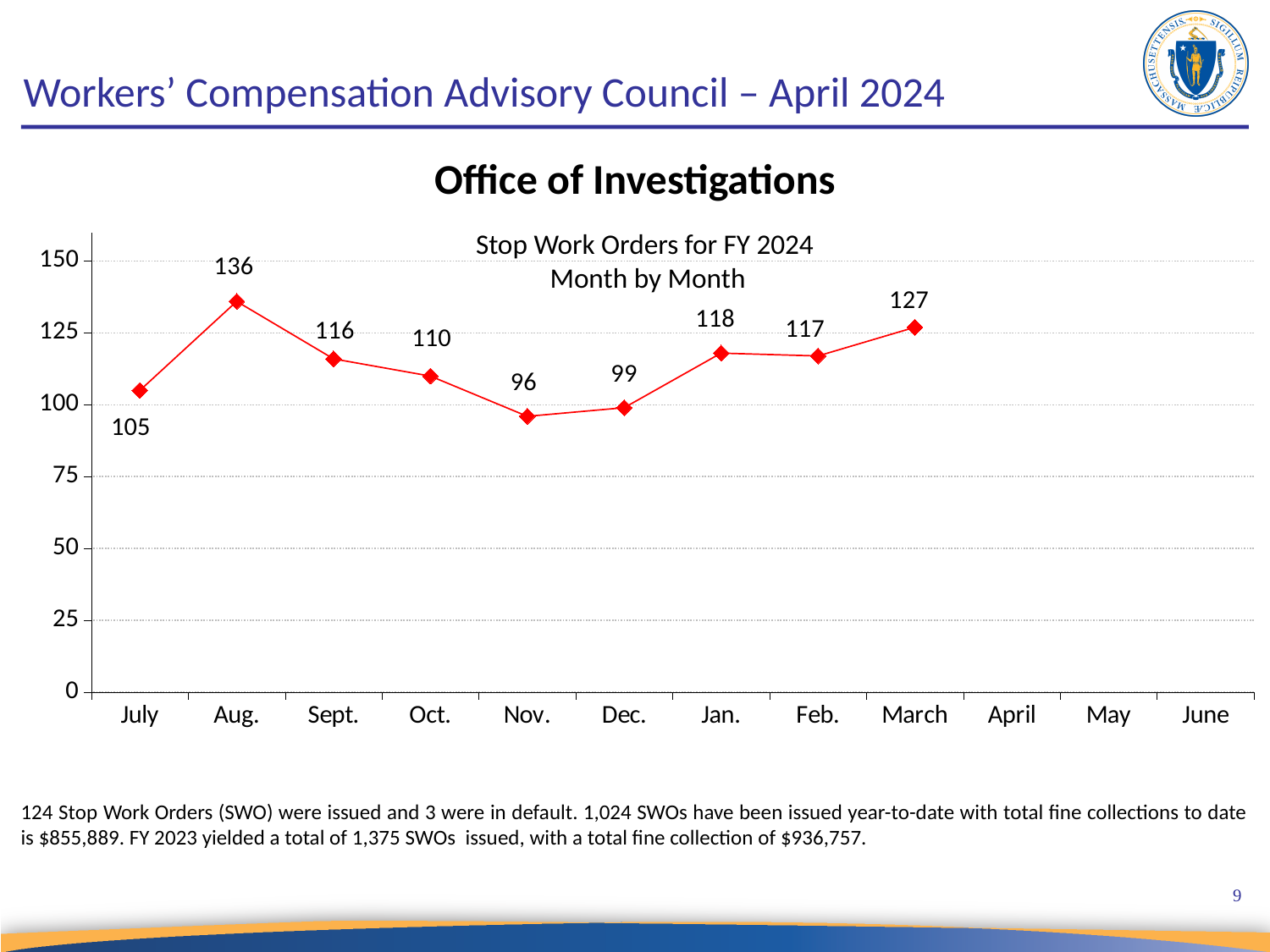
What is the value for Aug. in the Stop Work Orders for FY 2024 chart? 136 What is the difference between the values for Aug. and Nov. in the Stop Work Orders chart? 40 What kind of chart is used to show Stop Work Orders for FY 2024? Line chart Which month has the lowest number of Stop Work Orders in the chart? Nov. Which month has the highest number of Stop Work Orders in the chart? Aug. How many months have plotted data points in the Stop Work Orders for FY 2024 chart? 9 What is the value for March in the Stop Work Orders for FY 2024 chart? 127 Is the value for Oct. in the Stop Work Orders chart greater or less than 100? greater Do the values in the Stop Work Orders chart rise or fall from Nov. to March? Rise Which is larger in the Stop Work Orders chart, the value for Sept. or the value for Dec.? Sept. What is the title of the chart on the slide? Stop Work Orders for FY 2024 Month by Month What is the value for Nov. in the Stop Work Orders for FY 2024 chart? 96